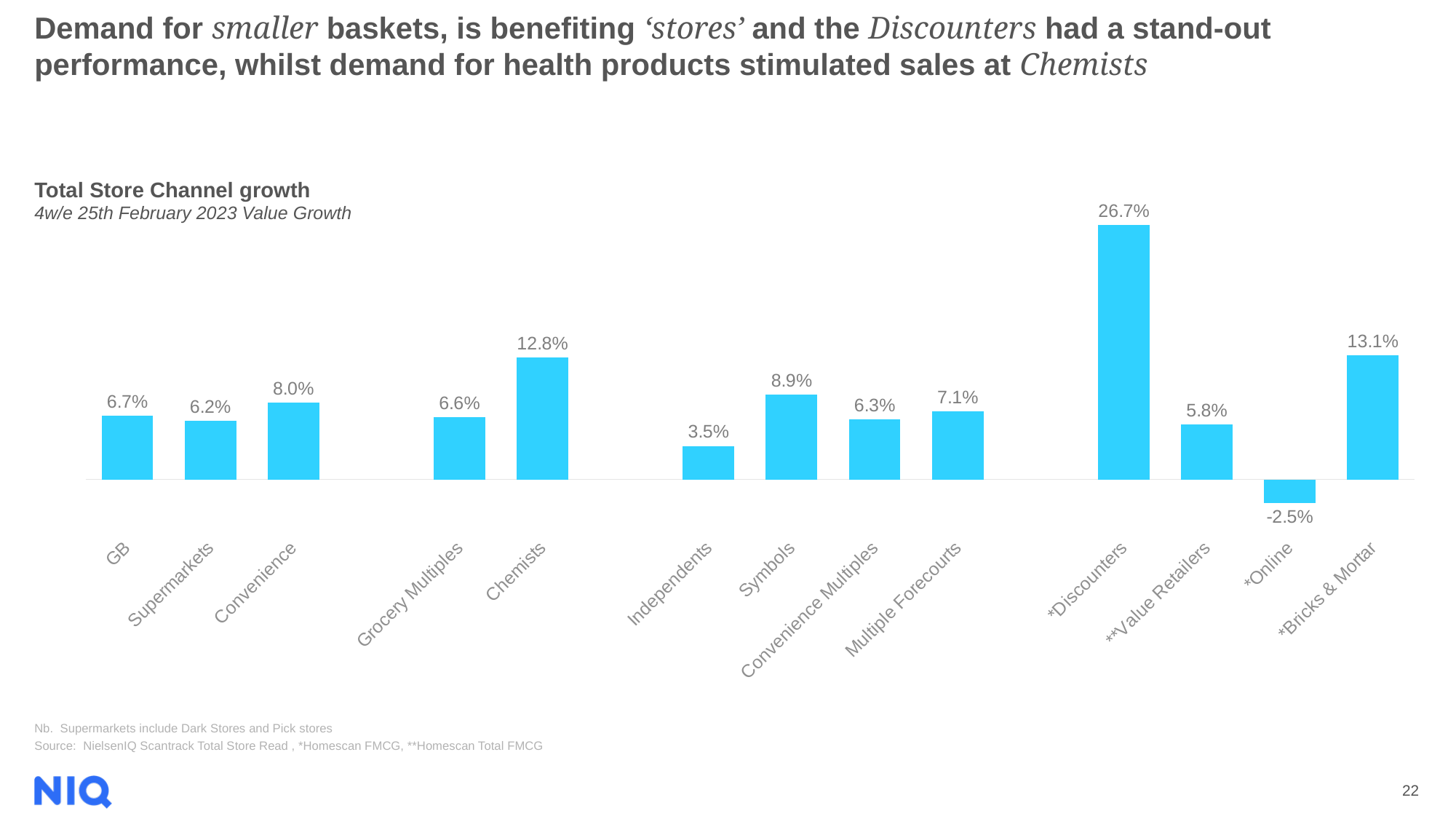
What is the value growth for Online? -2.5% What period does the chart cover, according to its subtitle? 4w/e 25th February 2023 What is the value growth for Supermarkets? 6.2% Which channel has the lowest value growth? Online What type of chart is used to show Total Store Channel growth? Bar chart Which channel has the highest value growth? Discounters How many channels are shown in the chart? 13 What is the difference in value growth between Chemists and Grocery Multiples? 6.2 percentage points Which has higher value growth, Symbols or Convenience? Symbols What is the value growth for Chemists? 12.8% What is the value growth for Multiple Forecourts? 7.1% What is the difference in value growth between Discounters and Bricks & Mortar? 13.6 percentage points